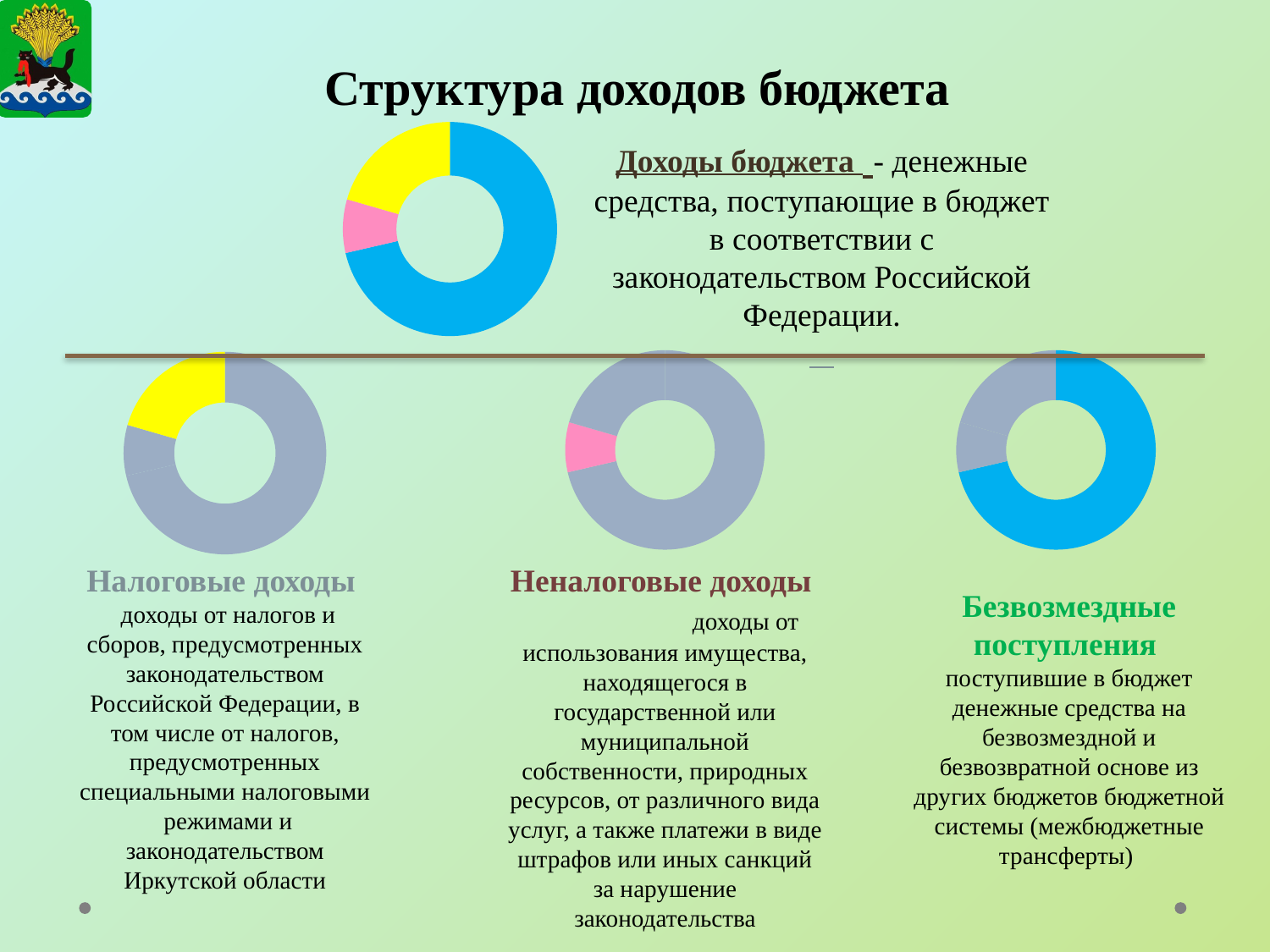
What kind of chart is the chart at the top of the slide, next to the definition of 'Доходы бюджета'? pie chart (donut) What is the title of the slide containing the charts? Структура доходов бюджета In the top chart on the slide, which colour slice is the smallest? pink How many pie (donut) charts are shown on the slide in total? 4 In the top chart on the slide, is the blue slice larger or smaller than the yellow and pink slices combined? larger In the chart above 'Безвозмездные поступления', is the highlighted blue slice larger or smaller than the grey remainder? larger In the top chart on the slide, which slice is larger, the blue one or the yellow one? blue How many slices does the top chart on the slide have? 3 In the top chart on the slide, which colour slice is the largest? blue In the chart above 'Неналоговые доходы', which colour is the highlighted slice? pink